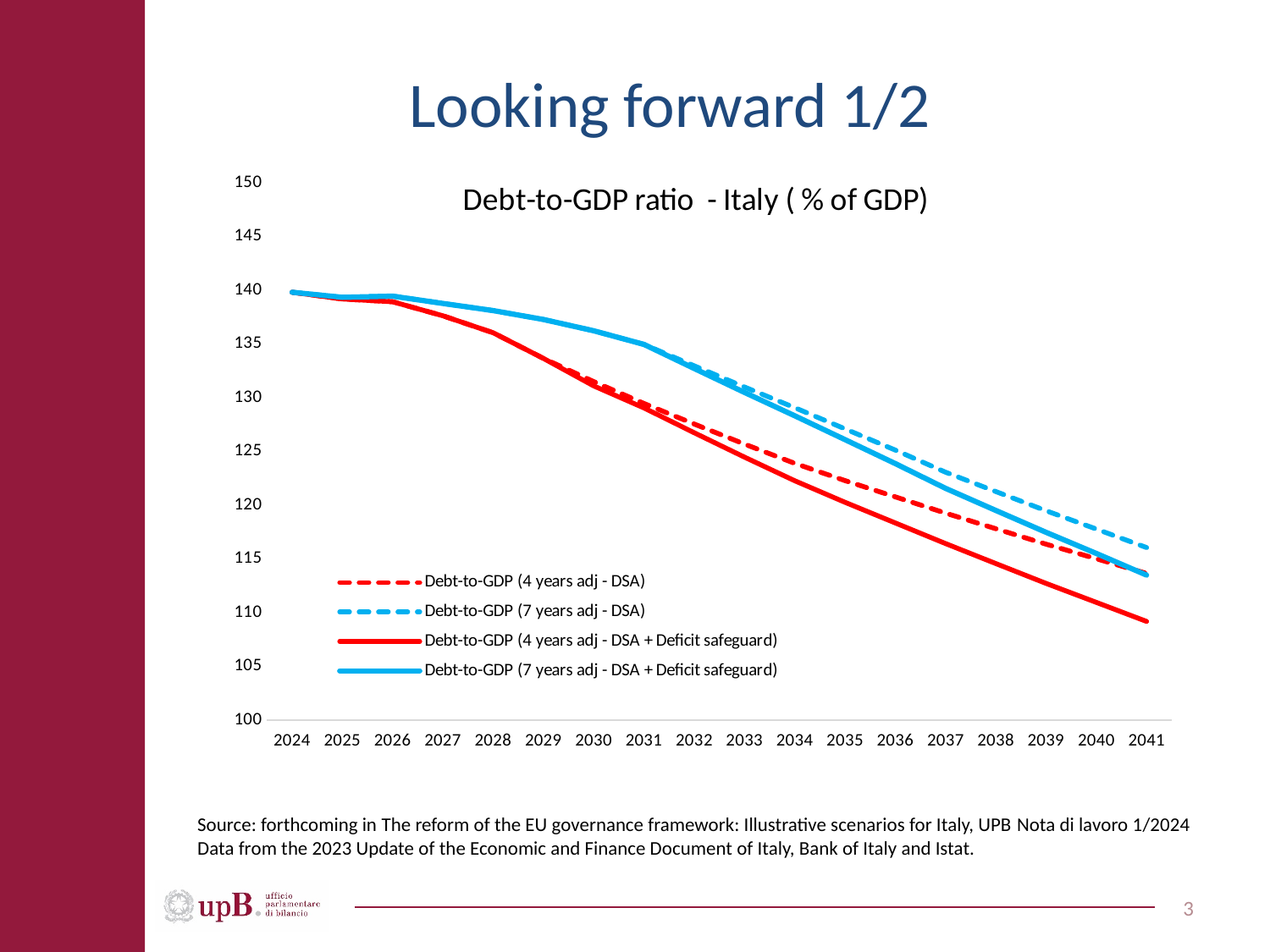
Which series has the lowest value in 2041? Debt-to-GDP (4 years adj - DSA + Deficit safeguard) How many years are shown on the x axis? 18 Is the 2041 value for Debt-to-GDP (4 years adj - DSA + Deficit safeguard) greater or less than 110? less What is the title of the chart? Debt-to-GDP ratio - Italy ( % of GDP) What kind of chart is shown on the slide? line chart Is the 2036 value for Debt-to-GDP (4 years adj - DSA + Deficit safeguard) greater or less than 120? less Which line style is used for the DSA-only scenarios in the legend? dashed How many series does the legend list? 4 Is the 2041 value for Debt-to-GDP (7 years adj - DSA) greater or less than 115? greater Which series has the highest value in 2041? Debt-to-GDP (7 years adj - DSA) Do the debt-to-GDP ratio lines rise or fall from 2024 to 2041? fall In 2041, which is larger: Debt-to-GDP (7 years adj - DSA) or Debt-to-GDP (4 years adj - DSA + Deficit safeguard)? Debt-to-GDP (7 years adj - DSA)